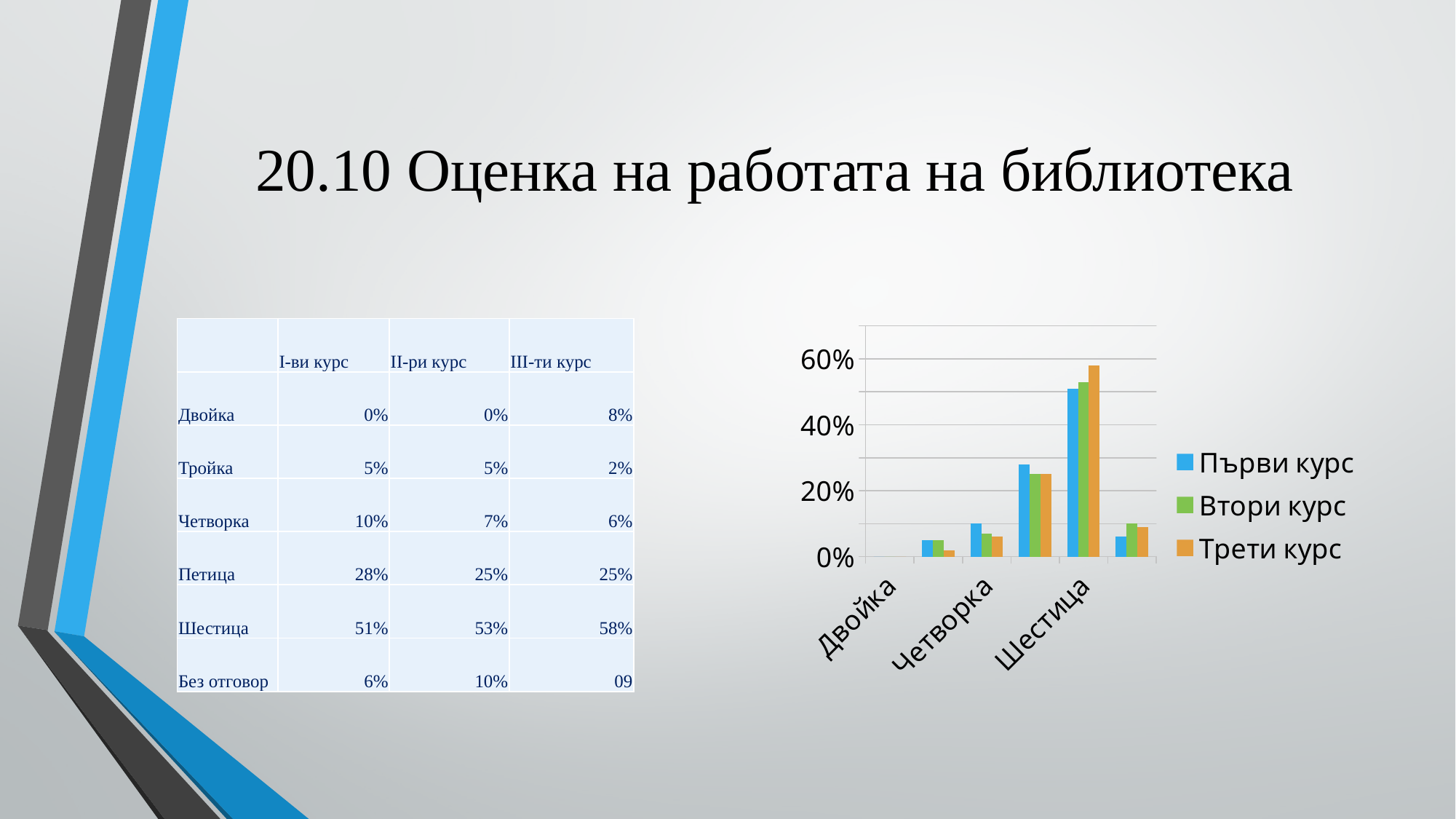
How many groups of bars are plotted along the x axis of the chart? 6 According to the table on the slide, what is the value for Шестица in III-ти курс? 58% What kind of chart is shown on the slide? bar chart For the category Четворка, which is larger: Първи курс or Втори курс? Първи курс Is the value for Трети курс in the category Шестица greater or less than 40%? greater How many series does the chart legend list? 3 Which series are listed in the chart legend? Първи курс, Втори курс, Трети курс Which category has the lowest bars in the chart? Двойка For the category Шестица, which series has the highest bar? Трети курс According to the table on the slide, what is the value for Петица in I-ви курс? 28% Which category has the tallest bars in the chart? Шестица Is the value for Първи курс in the category Четворка greater or less than 20%? less